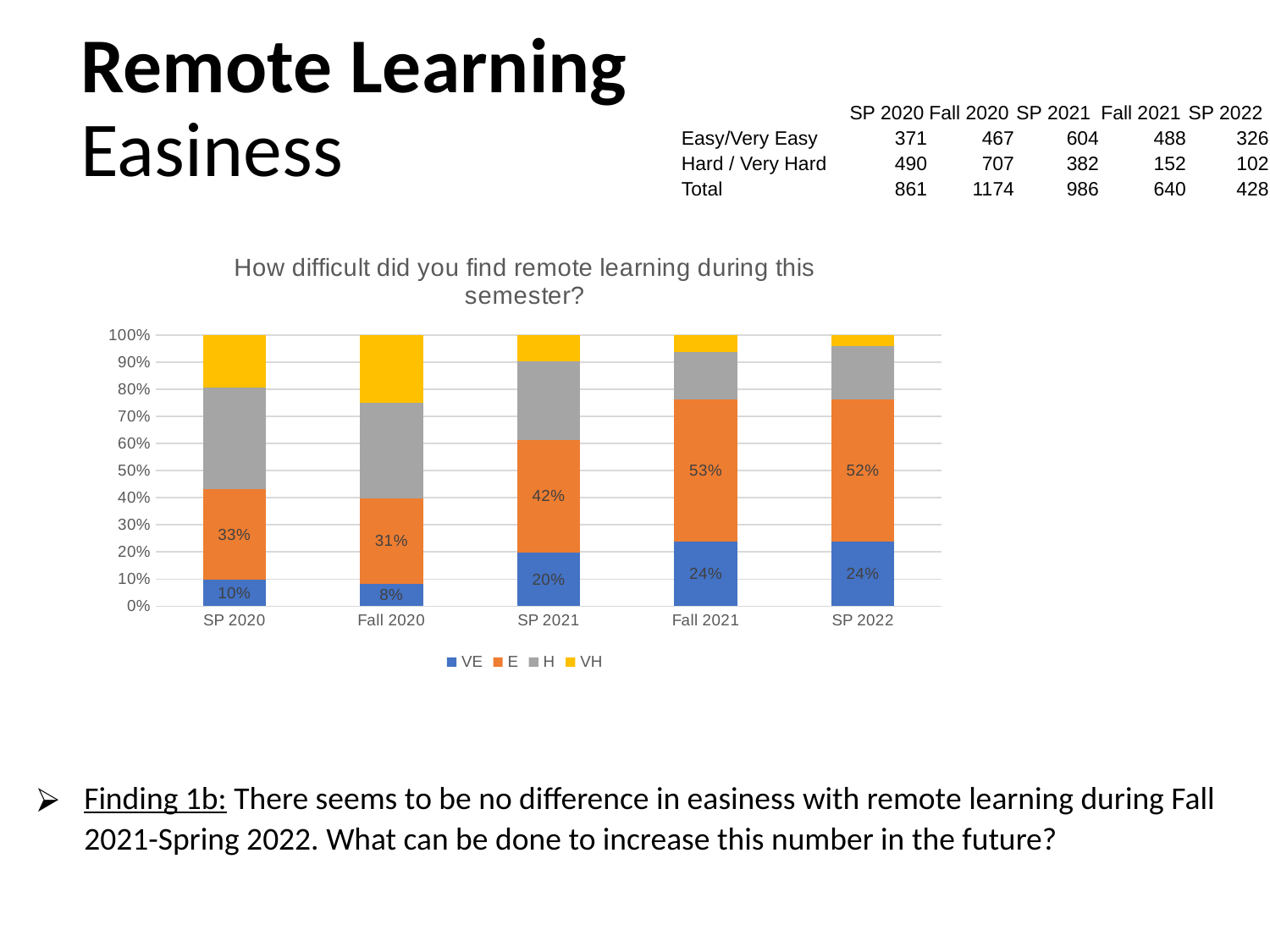
What is the VE value for SP 2021? 20% What is the title of the chart? How difficult did you find remote learning during this semester? Is the E value for SP 2022 greater or less than 40%? greater Which is larger, the VE value for SP 2021 or the VE value for SP 2020? SP 2021 How many semesters are shown on the x axis? 5 Which semester has the lowest VE value? Fall 2020 What is the difference between the E value for SP 2021 and the E value for SP 2020? 9% What is the E value for Fall 2020? 31% What is the VE value for SP 2020? 10% What is the E value for Fall 2021? 53% How many series does the legend list? 4 What kind of chart is shown? stacked bar chart